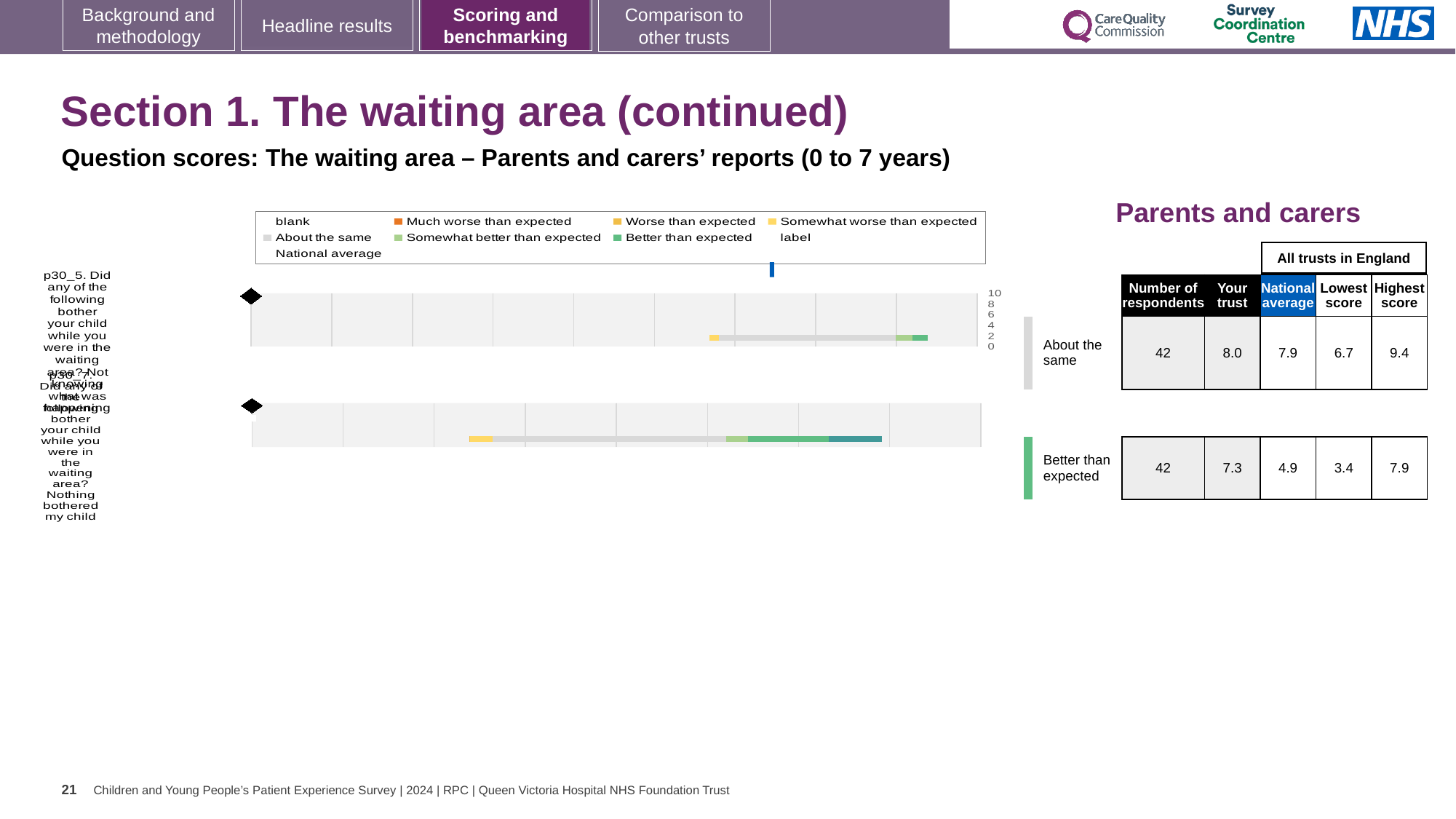
How many respondents are listed for each question in the table? 42 What kind of chart is shown on the slide? bar chart In the table, what is the national average for the question rated 'Better than expected'? 4.9 What is the highest value shown on the chart's axis? 10 By how much does the trust's score exceed the national average for the question rated 'Better than expected'? 2.4 In the table, what is the 'Your trust' score for the question rated 'About the same'? 8.0 Which colour does the legend use for 'Much worse than expected'? orange For the question rated 'About the same', which is larger: the trust's score or the national average? the trust's score In the table, what is the 'Your trust' score for the question rated 'Better than expected'? 7.3 How many question bars are plotted in the chart? 2 In the table, what is the lowest score across all trusts in England for the question rated 'Better than expected'? 3.4 In the table, what is the highest score across all trusts in England for the question rated 'About the same'? 9.4